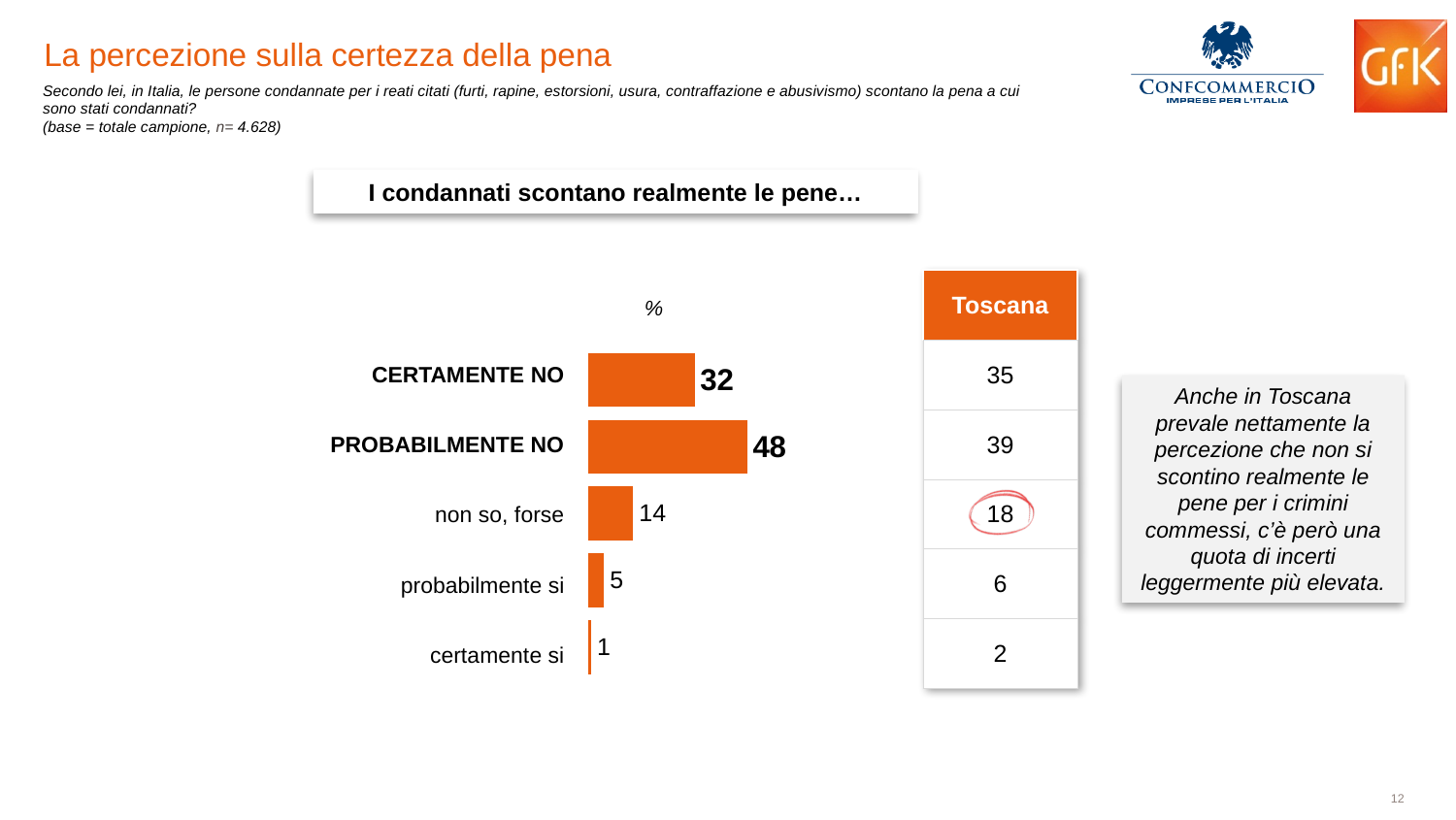
What is the title shown in the box above the bar chart? I condannati scontano realmente le pene… What is the value for "certamente si" in the bar chart? 1 What is the value for "non so, forse" in the bar chart? 14 What is the value for "CERTAMENTE NO" in the bar chart? 32 What type of chart is shown on the slide? bar chart Which category has the lowest value in the bar chart? certamente si What is the sum of the values for "CERTAMENTE NO" and "PROBABILMENTE NO" in the bar chart? 80 What is the value for "PROBABILMENTE NO" in the bar chart? 48 Which category has the highest value in the bar chart? PROBABILMENTE NO What is the difference between the values for "PROBABILMENTE NO" and "CERTAMENTE NO"? 16 How many categories are shown in the bar chart? 5 Which is larger: the value for "non so, forse" or the value for "probabilmente si"? non so, forse